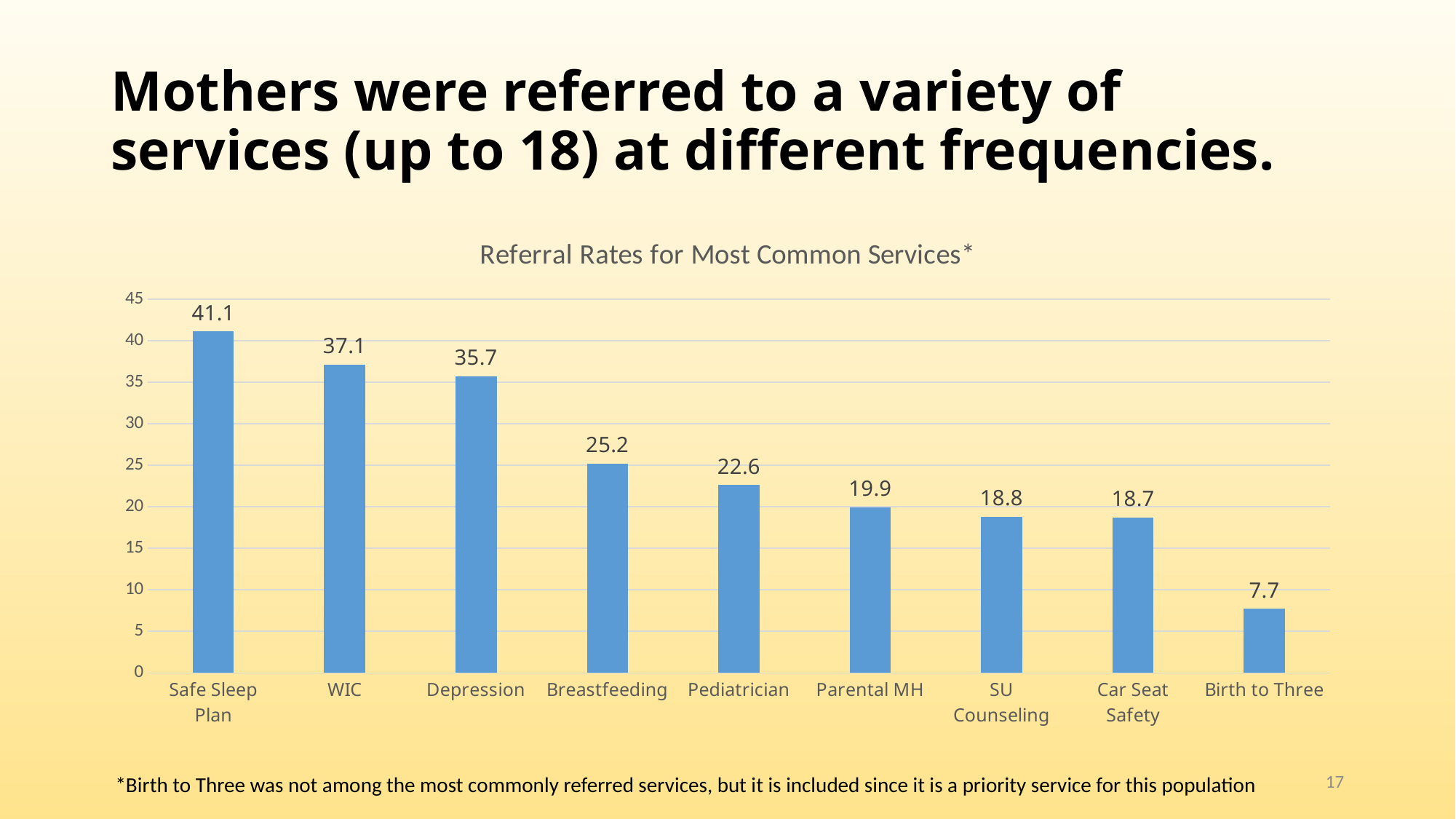
What is the difference between the referral rates for Safe Sleep Plan and Depression? 5.4 What is the referral rate for Pediatrician? 22.6 Which service has the highest referral rate? Safe Sleep Plan What is the referral rate for Birth to Three? 7.7 What kind of chart is shown on the slide? Bar chart Is the referral rate for Pediatrician greater or less than 20? greater How many services are shown in the chart? 9 Which has a higher referral rate, Depression or Breastfeeding? Depression What is the title of the chart? Referral Rates for Most Common Services* What is the difference between the referral rates for Breastfeeding and Parental MH? 5.3 Which service has the lowest referral rate? Birth to Three What is the referral rate for WIC? 37.1